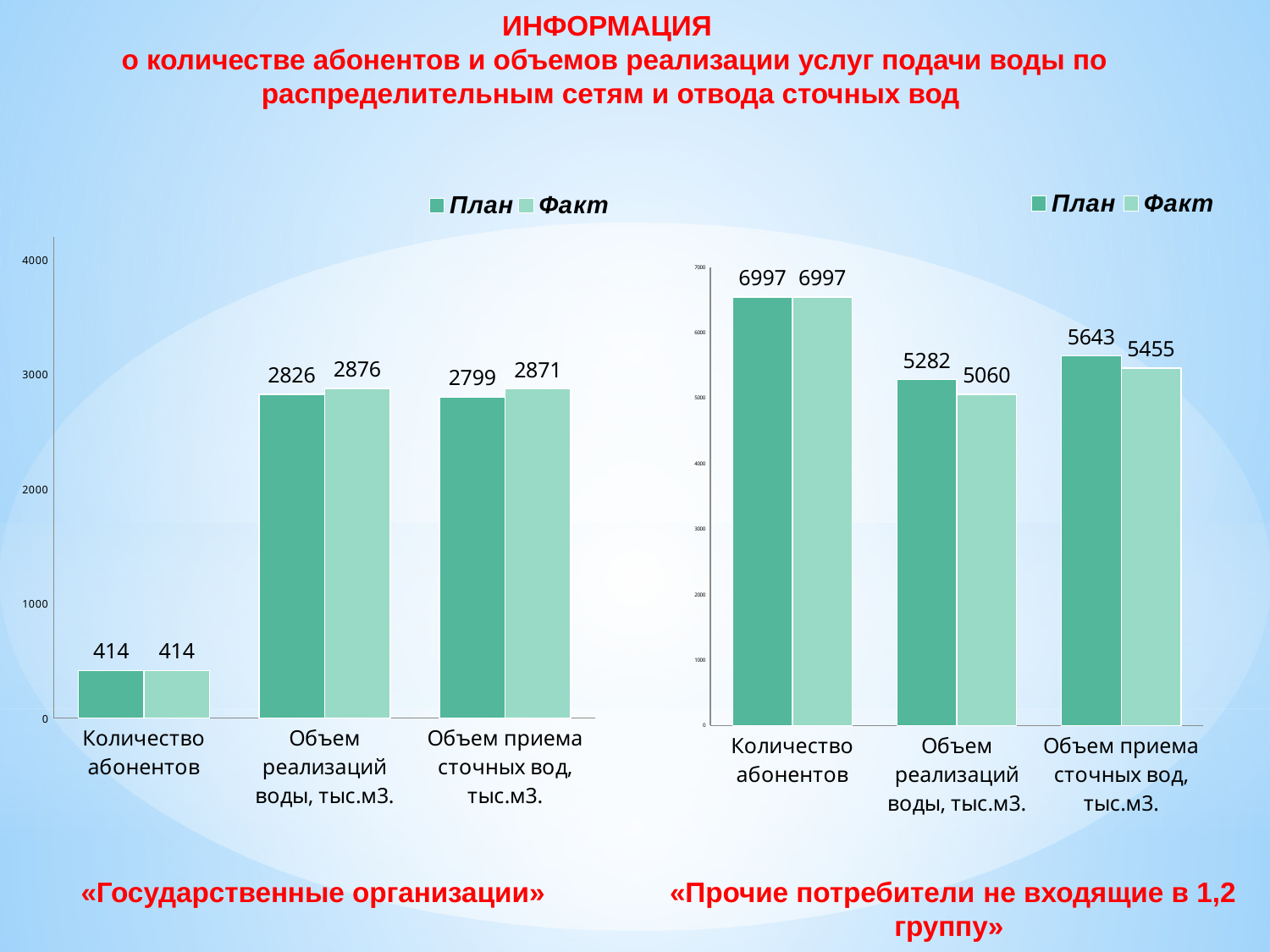
In the right chart («Прочие потребители не входящие в 1,2 группу»), what is the Факт value for Объем реализаций воды, тыс.м3.? 5060 In the right chart («Прочие потребители не входящие в 1,2 группу»), which category has the highest План value? Количество абонентов In the left chart («Государственные организации»), what is the difference between the Факт and План values for Объем приема сточных вод, тыс.м3.? 72 In the right chart («Прочие потребители не входящие в 1,2 группу»), which is larger for Объем приема сточных вод, тыс.м3.: План or Факт? План In the left chart («Государственные организации»), what is the План value for Объем реализаций воды, тыс.м3.? 2826 In the right chart («Прочие потребители не входящие в 1,2 группу»), what is the difference between the План and Факт values for Объем реализаций воды, тыс.м3.? 222 In the right chart («Прочие потребители не входящие в 1,2 группу»), what is the План value for Объем приема сточных вод, тыс.м3.? 5643 How many categories are shown on the x axis of the right chart («Прочие потребители не входящие в 1,2 группу»)? 3 What kind of chart is the left chart («Государственные организации»)? Bar chart In the left chart («Государственные организации»), which category has the lowest Факт value? Количество абонентов In the left chart («Государственные организации»), what is the Факт value for Объем приема сточных вод, тыс.м3.? 2871 How many series does the legend of the left chart («Государственные организации») list? 2